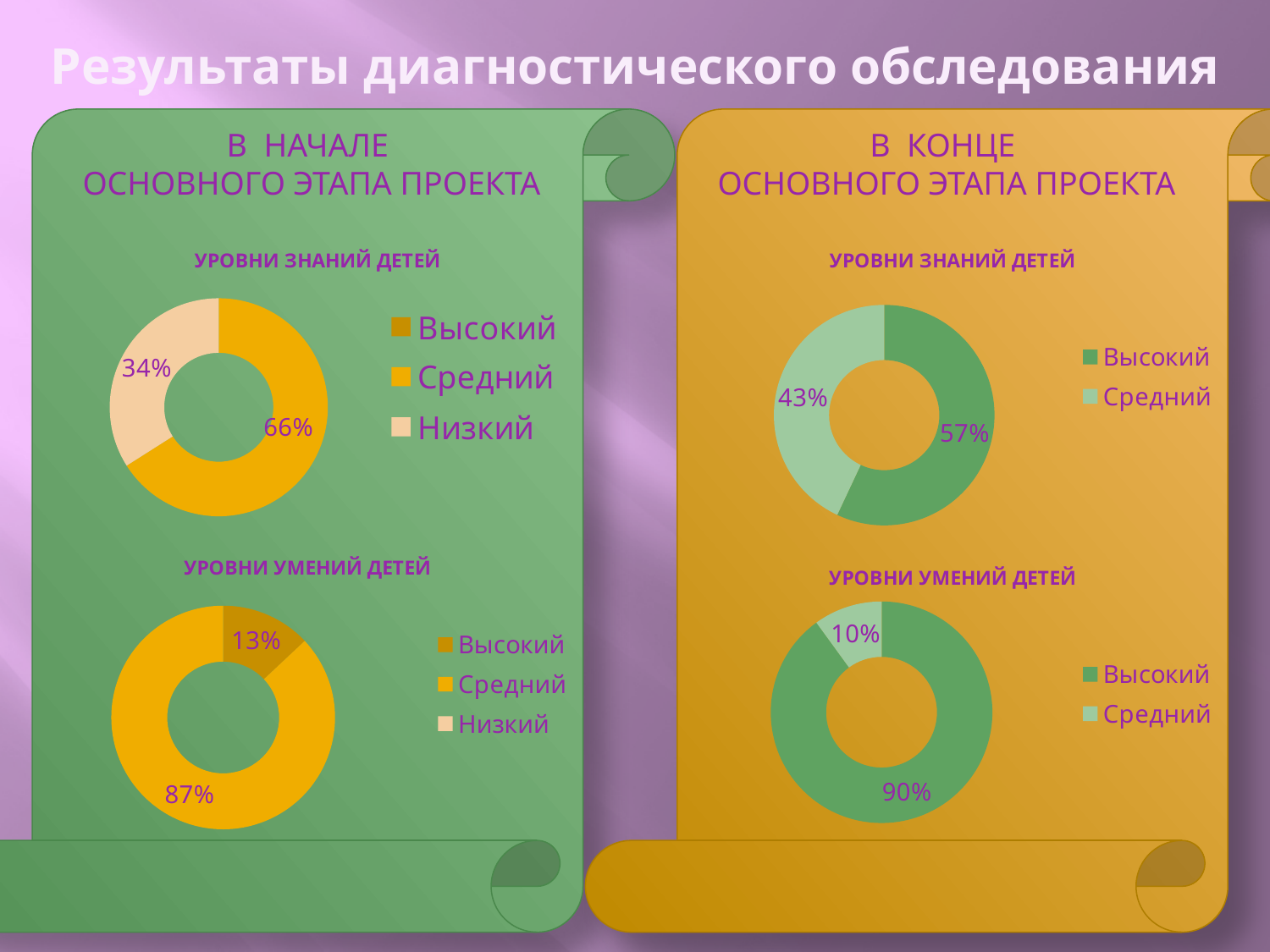
On the 'Уровни знаний детей' chart in the left panel ('В начале основного этапа проекта'), what share is labelled for the Средний slice? 66% On the 'Уровни умений детей' chart in the left panel ('В начале основного этапа проекта'), which labelled category has the smallest slice? Высокий On the 'Уровни знаний детей' chart in the right panel ('В конце основного этапа проекта'), what share is labelled for the Средний slice? 43% On the 'Уровни знаний детей' chart in the right panel ('В конце основного этапа проекта'), which category has the largest slice? Высокий On the 'Уровни умений детей' chart in the right panel ('В конце основного этапа проекта'), what share is labelled for the Средний slice? 10% On the 'Уровни знаний детей' chart in the right panel ('В конце основного этапа проекта'), what is the difference between the Высокий and Средний shares? 14% On the 'Уровни знаний детей' chart in the left panel ('В начале основного этапа проекта'), what share is labelled for the Низкий slice? 34% On the 'Уровни умений детей' chart in the left panel ('В начале основного этапа проекта'), what share is labelled for the Средний slice? 87% On the 'Уровни знаний детей' chart in the right panel ('В конце основного этапа проекта'), what share is labelled for the Высокий slice? 57% On the 'Уровни умений детей' chart in the left panel ('В начале основного этапа проекта'), what share is labelled for the Высокий slice? 13% How many entries does the legend list for the 'Уровни знаний детей' chart in the left panel ('В начале основного этапа проекта')? 3 On the 'Уровни умений детей' chart in the right panel ('В конце основного этапа проекта'), what share is labelled for the Высокий slice? 90%